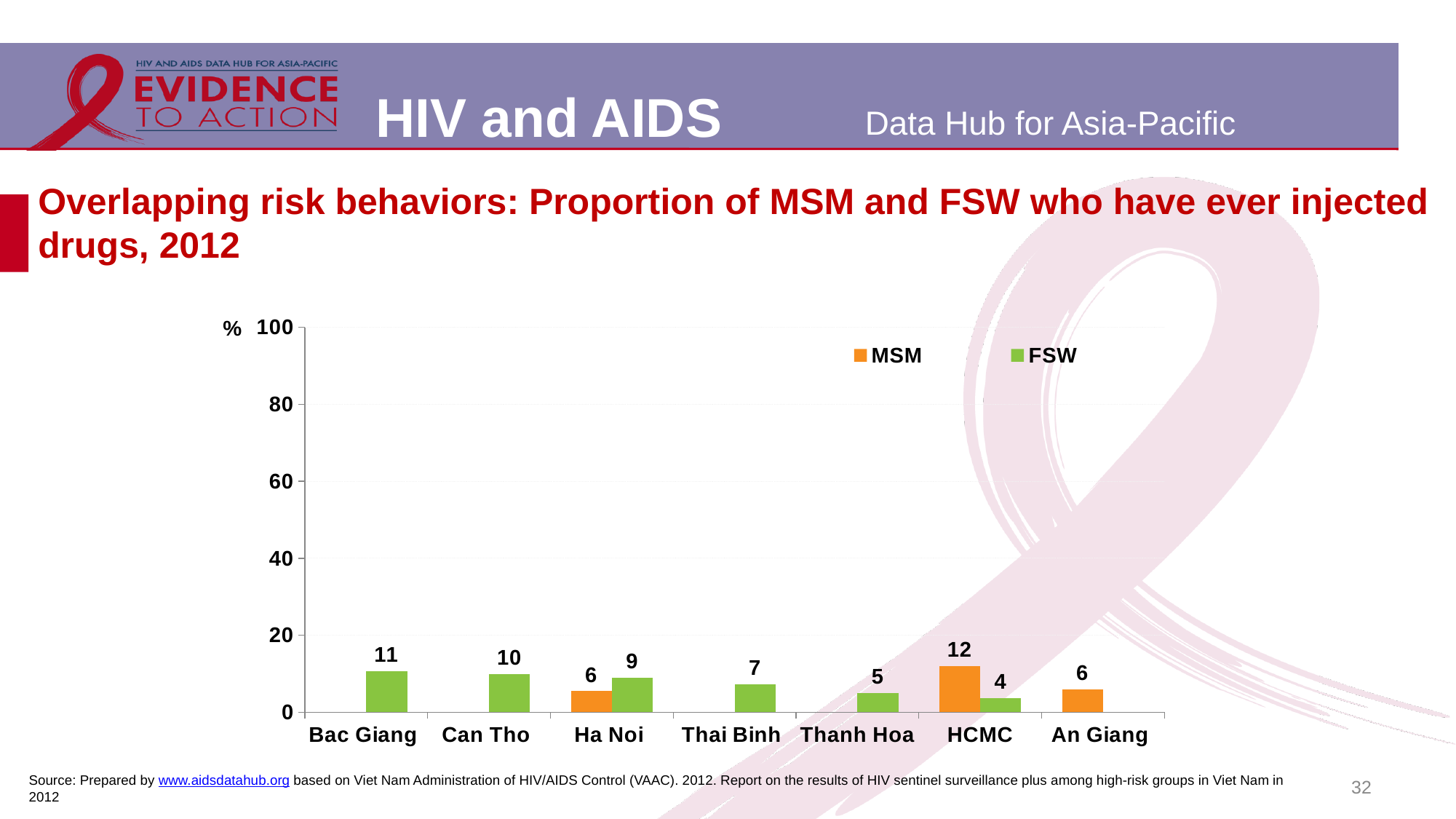
Which is larger in Ha Noi, the MSM value or the FSW value? FSW Which province has the highest FSW value? Bac Giang Which province has the lowest FSW value? HCMC How many series does the legend list? 2 What is the MSM value for HCMC? 12 What kind of chart is shown on the slide? bar chart Is the FSW value for Can Tho greater or less than 20? less How many provinces are shown on the x axis? 7 What is the MSM value for An Giang? 6 What is the difference between the MSM and FSW values for HCMC? 8 What is the FSW value for Bac Giang? 11 What is the FSW value for Ha Noi? 9